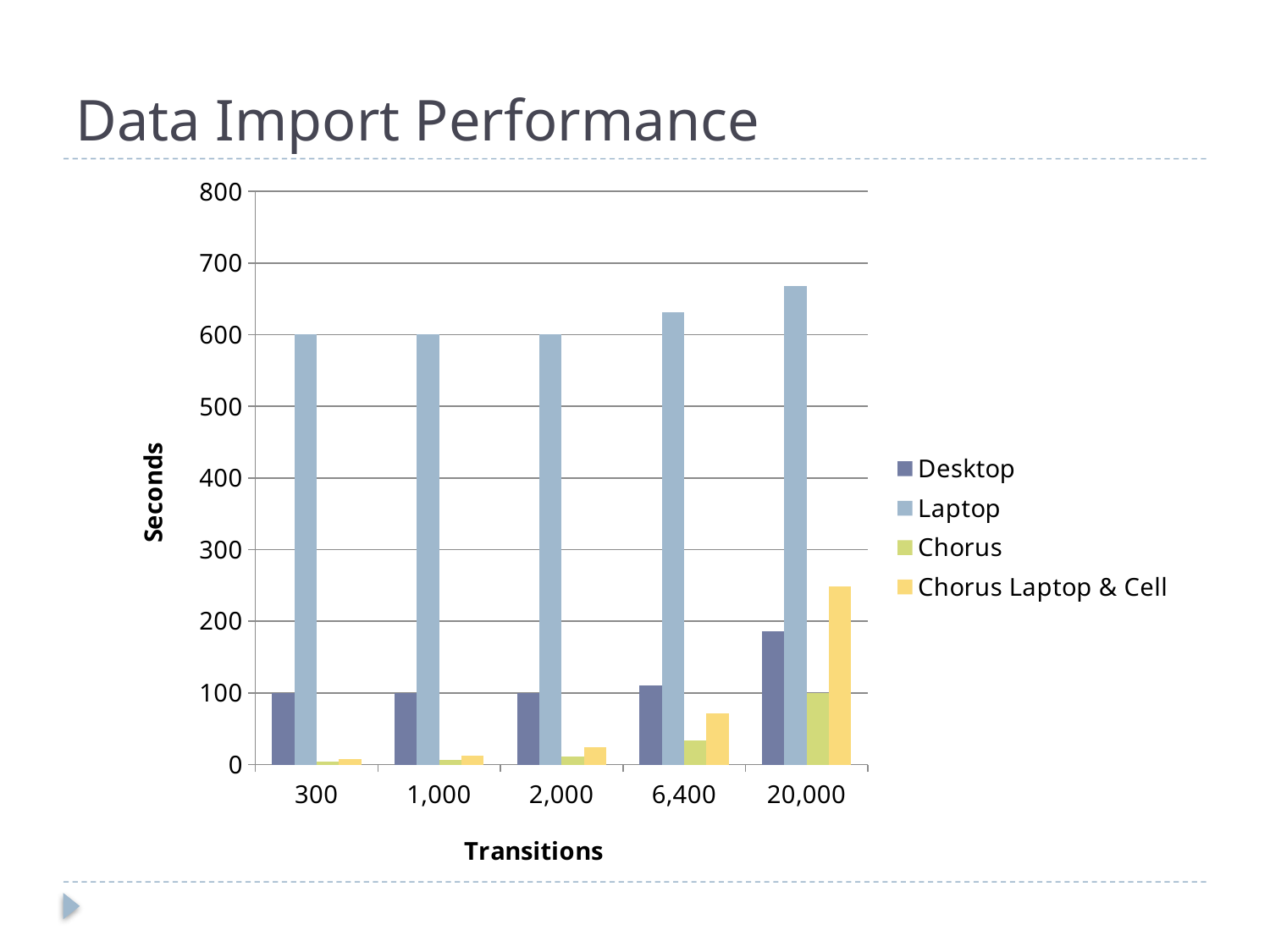
Is the Chorus Laptop & Cell value at 20,000 transitions greater or less than 200? greater What kind of chart is shown on the slide? bar chart How many categories are shown on the x axis? 5 What is the Laptop value at 300 transitions? 600 Which series has the lowest value at 6,400 transitions? Chorus Is the Laptop value at 20,000 transitions greater or less than 600? greater What is the Desktop value at 1,000 transitions? 100 Which series has the highest value at 20,000 transitions? Laptop How many series does the legend list? 4 What is the label of the y axis? Seconds Which is larger at 6,400 transitions, Desktop or Chorus Laptop & Cell? Desktop Do the Chorus Laptop & Cell values rise or fall as transitions increase along the x axis? rise